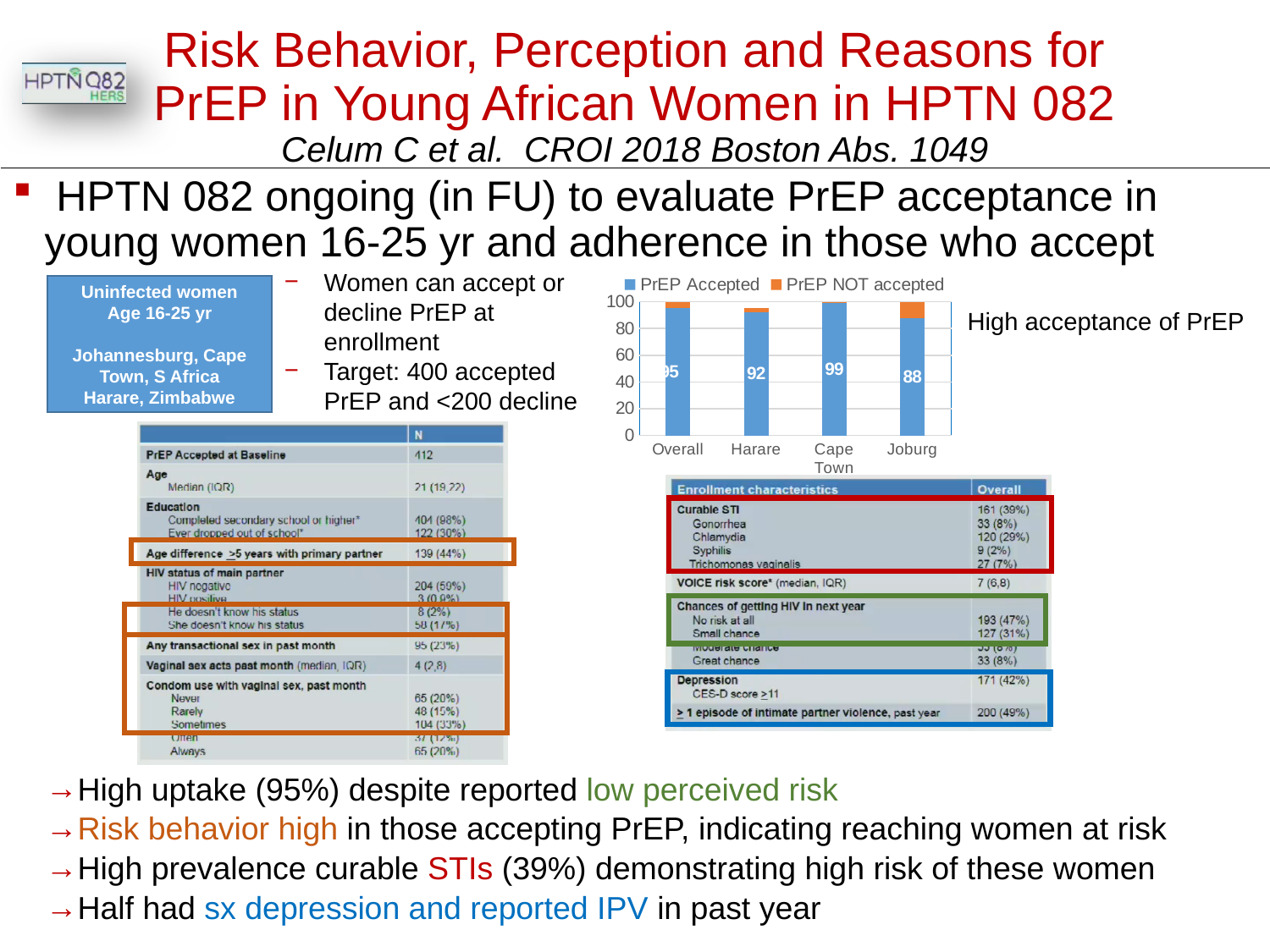
Which site has the highest PrEP Accepted value? Cape Town Which has a larger PrEP Accepted value, Harare or Joburg? Harare How many series does the chart legend list? 2 How many categories are shown on the x axis of the chart? 4 What is the PrEP Accepted value for Harare? 92 What are the two series named in the chart legend? PrEP Accepted and PrEP NOT accepted What type of chart is shown on the slide? stacked bar chart Is the PrEP NOT accepted value for Joburg greater or less than 20? less What is the PrEP Accepted value for Cape Town? 99 Which category has the lowest PrEP Accepted value? Joburg What is the difference between the PrEP Accepted values for Cape Town and Joburg? 11 What is the PrEP Accepted value for Joburg? 88